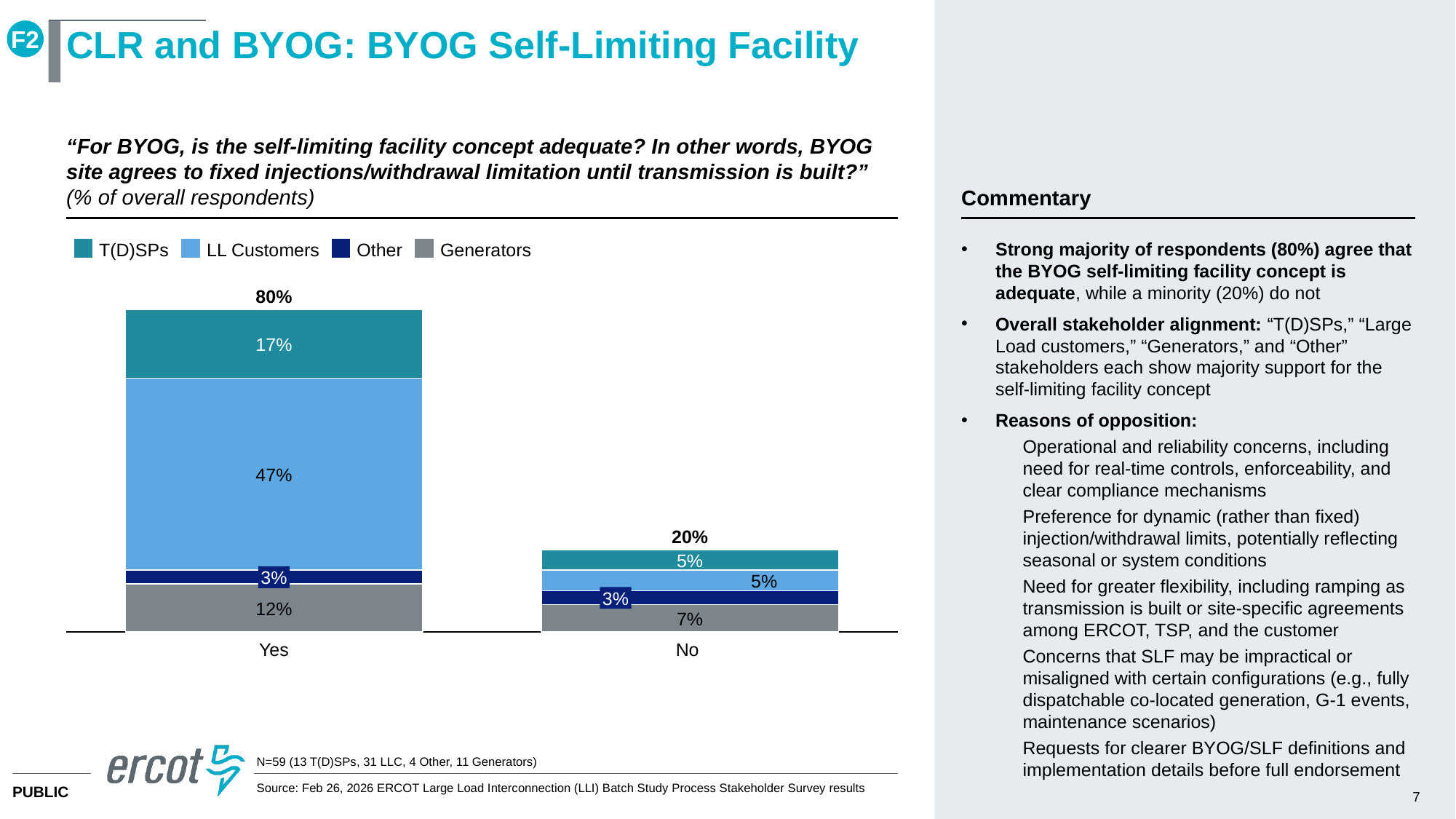
What is the total for the Yes bar? 80% How many series does the legend list? 4 What kind of chart is shown? Stacked bar chart What is the total for the No bar? 20% What is the T(D)SPs value in the No bar? 5% What is the Other value in the No bar? 3% What is the LL Customers value in the Yes bar? 47% How many categories are shown on the x axis? 2 What is the difference between the T(D)SPs values for Yes and No? 12% Which category has the higher total, Yes or No? Yes What is the Generators value in the Yes bar? 12% What is the difference between the Yes total and the No total? 60%